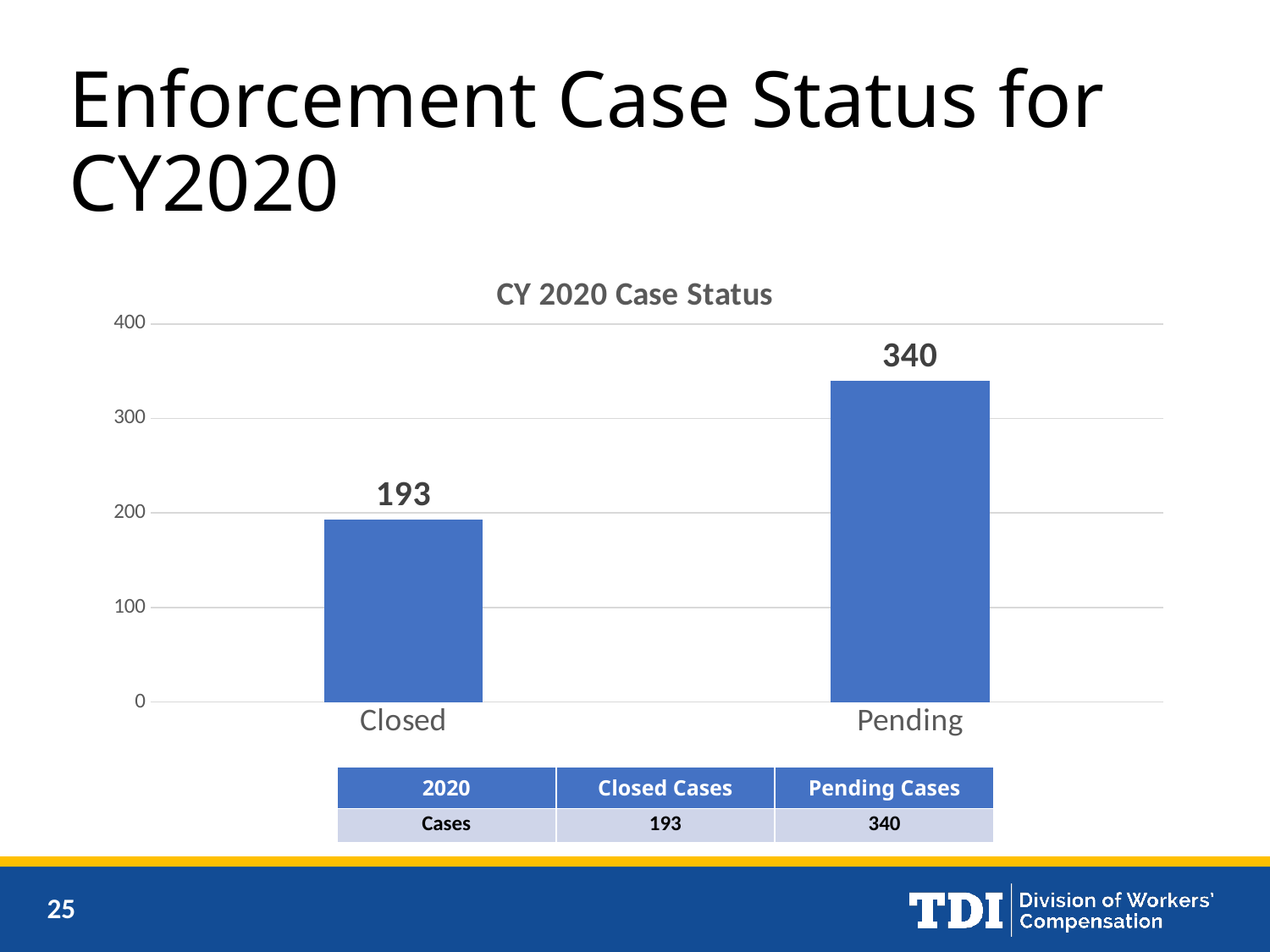
What is the difference between the Pending and Closed values? 147 What is the value for Pending cases in the CY 2020 Case Status chart? 340 How many categories are shown on the x axis of the chart? 2 Is the value for Closed greater or less than 200? less Is the value for Pending greater or less than 300? greater What is the highest value shown on the y axis of the chart? 400 What kind of chart is shown on the slide? bar chart What is the title of the chart? CY 2020 Case Status What is the value for Closed cases in the CY 2020 Case Status chart? 193 Which is larger, the value for Closed or the value for Pending? Pending Which category has the highest value in the chart? Pending Which category has the lowest value in the chart? Closed